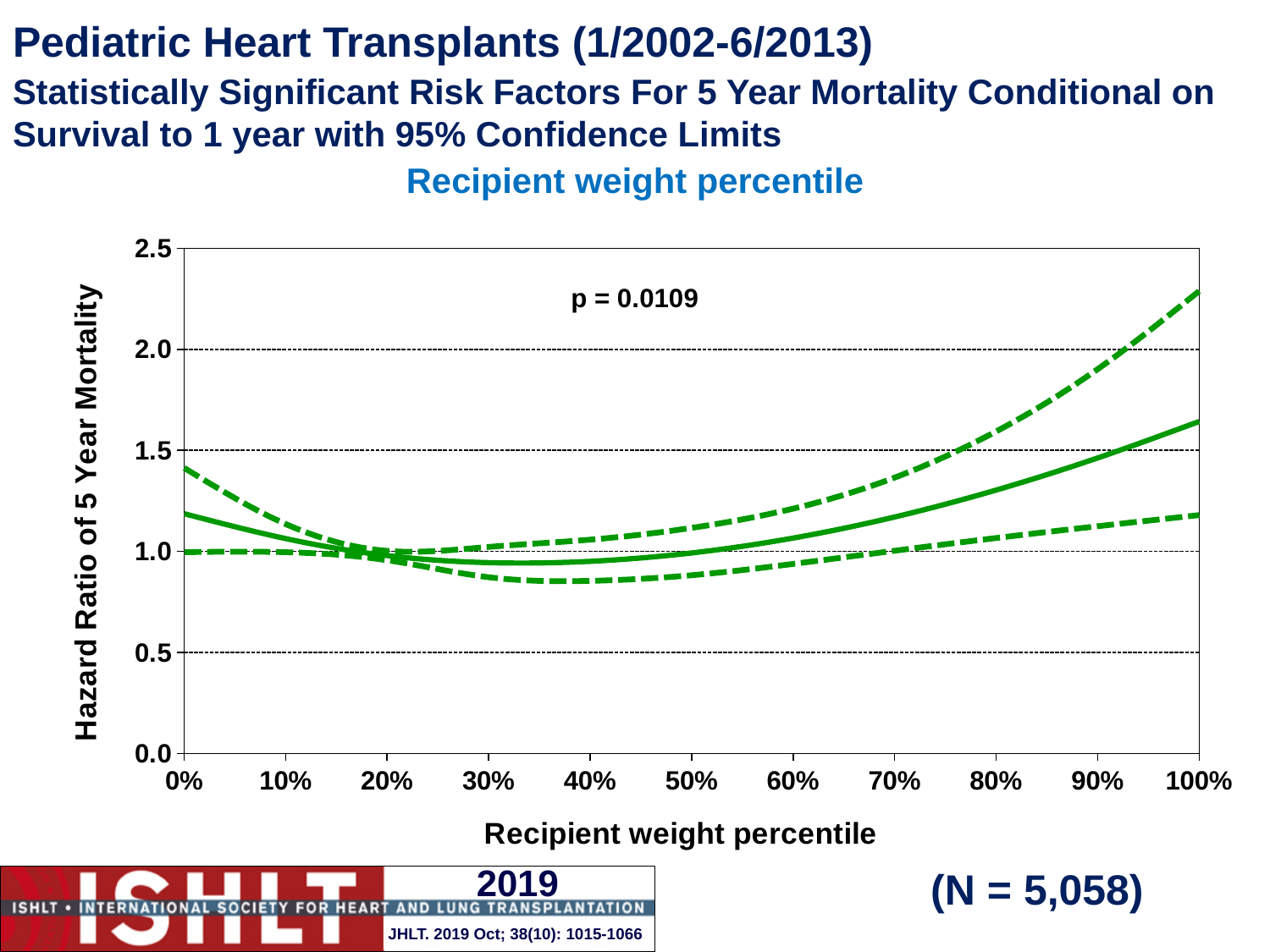
Is the lower 95% confidence limit (lower dashed line) at a recipient weight percentile of 40% greater or less than 1.0? less How many tick labels are shown on the x axis (recipient weight percentile)? 11 What is the sample size (N) shown on the slide? N = 5,058 Does the hazard ratio (solid line) rise or fall as the recipient weight percentile increases from 50% to 100%? rise Is the upper 95% confidence limit (upper dashed line) at a recipient weight percentile of 100% greater or less than 2.0? greater Is the hazard ratio (solid line) at a recipient weight percentile of 0% greater or less than 1.0? greater Which is larger: the hazard ratio (solid line) at a recipient weight percentile of 0% or at 100%? 100% What kind of chart is shown on the slide? line chart Does the hazard ratio (solid line) rise or fall as the recipient weight percentile increases from 0% to 30%? fall What is the p-value printed on the chart? p = 0.0109